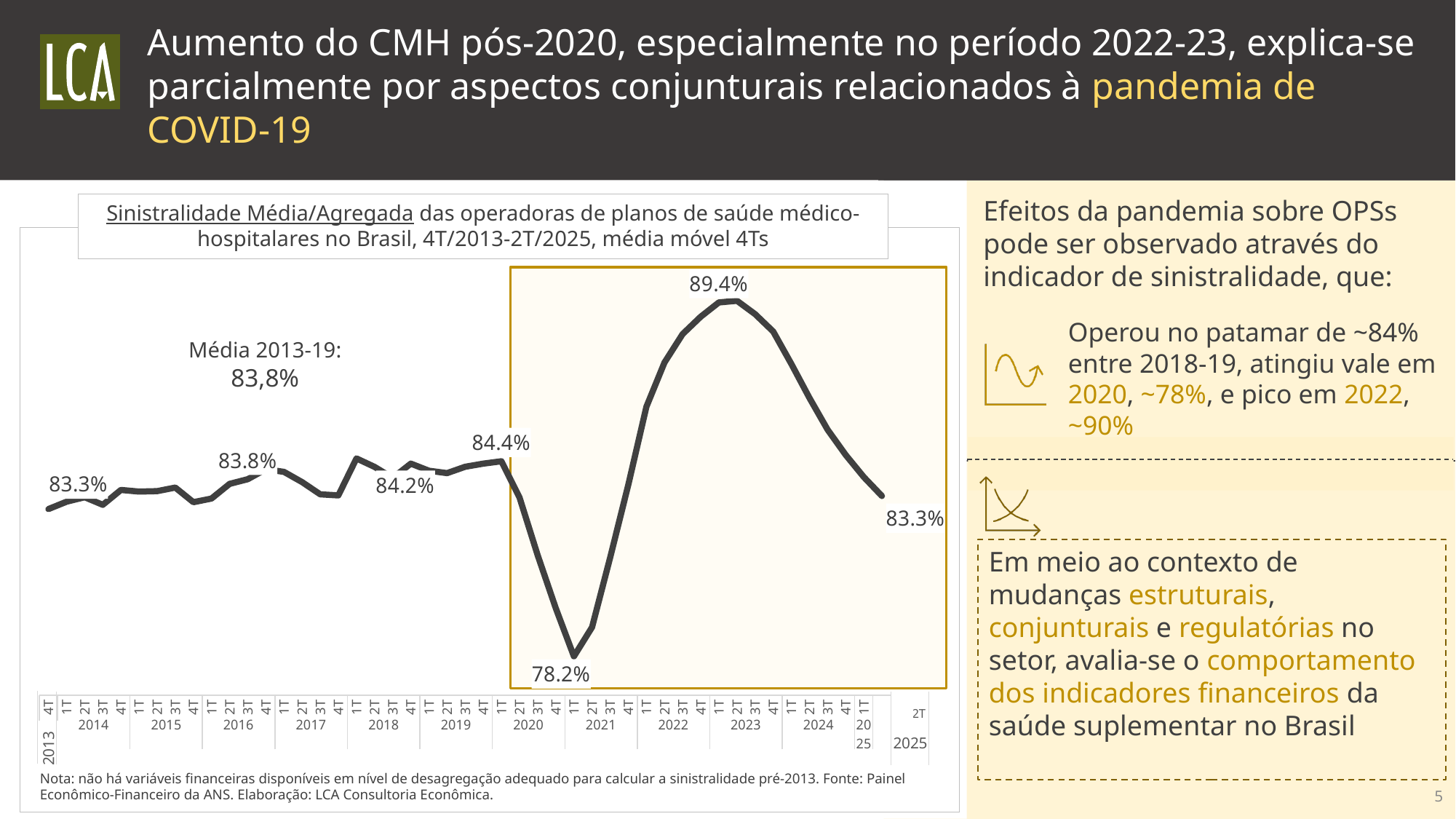
What is the highest value labelled on the line, reached in 2023? 89.4% What is the sinistralidade value labelled at the start of the series, in 4T/2013? 83.3% What is the difference in percentage points between the 1T/2020 value (84.4%) and the 2021 trough (78.2%)? 6.2 percentage points What is the value labelled at 1T/2020, just before the pandemic drop? 84.4% Does the line rise or fall between the 2023 peak and 2T/2025? fall Which is larger: the value at the 2023 peak or the value at 1T/2020? the 2023 peak (89.4%) What average for 2013-19 is annotated on the chart? 83,8% What is the difference in percentage points between the 2023 peak (89.4%) and the 2021 trough (78.2%)? 11.2 percentage points Does the line rise or fall between 1T/2021 and the 2023 peak? rise What kind of chart is shown on the slide? line chart What is the lowest value labelled on the line, reached in 2021? 78.2% What is the sinistralidade value labelled at the end of the series, in 2T/2025? 83.3%